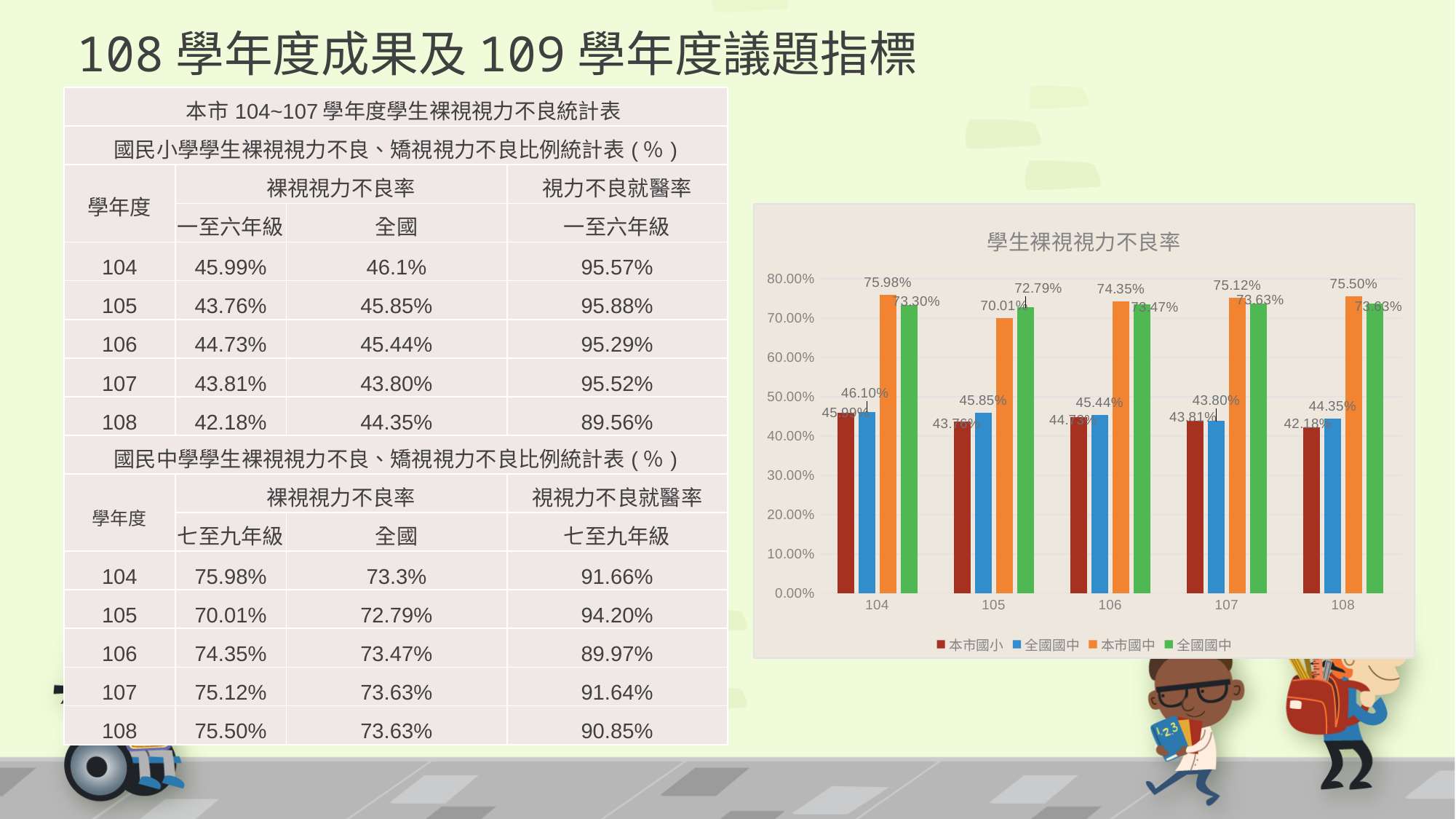
In which school year is the value for 本市國中 highest in the chart? 104 In which school year is the value for 本市國小 lowest in the chart? 108 Is the value for 本市國中 larger in school year 104 or in school year 105? 104 What kind of chart is shown on the slide? bar chart What is the value for 本市國小 in school year 104 in the chart? 45.99% What is the title of the chart? 學生裸視視力不良率 What is the value for 本市國中 in school year 105 in the chart? 70.01% How many school years (categories) are shown on the x axis of the chart? 5 How many series does the chart legend list? 4 Overall, does the value for 本市國小 rise or fall from school year 104 to 108 in the chart? fall In school year 108, what is the difference between the 本市國中 value and the 本市國小 value in the chart? 33.32% Is the value for 本市國小 in school year 106 greater or less than 50.00%? less